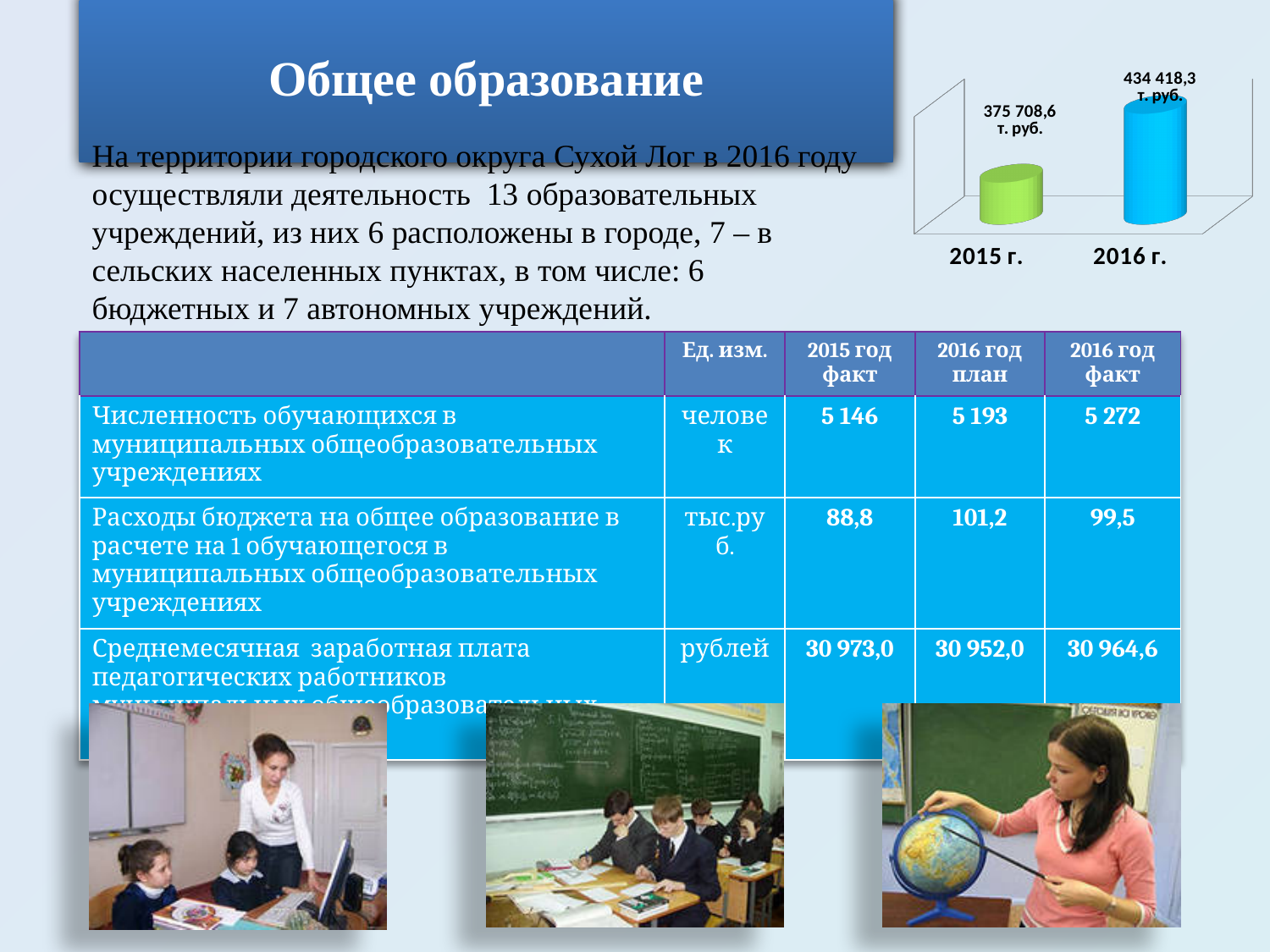
What value is shown for 2016 г. in the bar chart? 434 418,3 т. руб. What type of chart is shown in the top right of the slide? bar chart Is the value for 2016 г. larger or smaller than the value for 2015 г. in the bar chart? larger Which year has the lower value in the bar chart? 2015 г. What colour is the bar for 2016 г. in the chart? blue What value is shown for 2015 г. in the bar chart? 375 708,6 т. руб. By how much does the 2016 г. value exceed the 2015 г. value in the bar chart? 58 709,7 т. руб. Do the values in the bar chart rise or fall from 2015 г. to 2016 г.? rise Which year has the higher value in the bar chart? 2016 г. How many bars are plotted in the chart? 2 What colour is the bar for 2015 г. in the chart? green